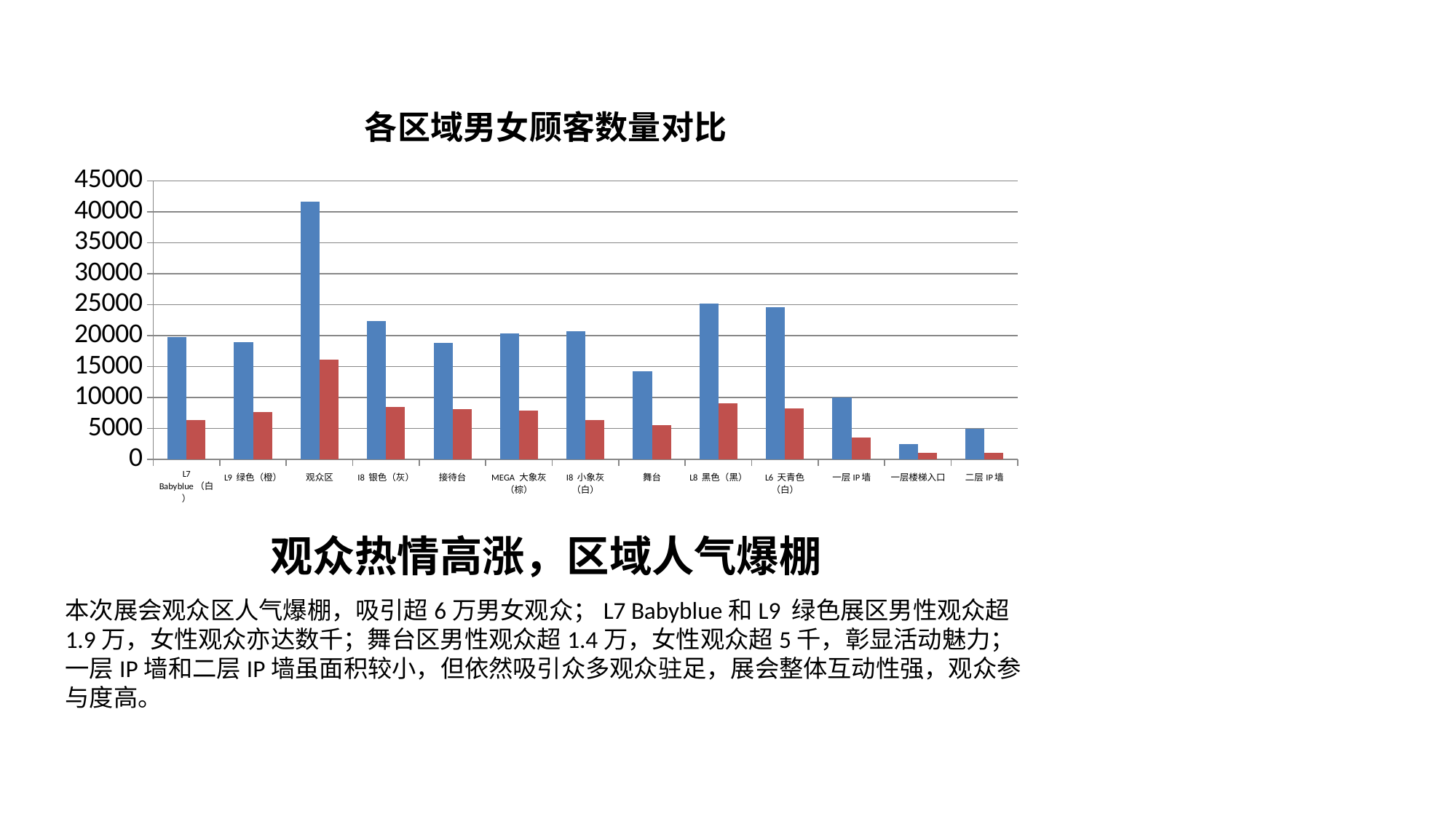
Is the blue bar for 一层楼梯入口 greater or less than 5000? less Which category has the tallest blue bar? 观众区 What kind of chart is shown on the slide? bar chart What is the title of the chart? 各区域男女顾客数量对比 Is the red bar for 观众区 greater or less than 15000? greater Is the blue bar for 舞台 greater or less than 15000? less Which category has the tallest red bar? 观众区 Which has the taller blue bar, 观众区 or I8 银色（灰）? 观众区 Which has the taller blue bar, 舞台 or L8 黑色（黑）? L8 黑色（黑） Which category has the shortest blue bar? 一层楼梯入口 How many categories (regions) are shown on the x axis of the chart? 13